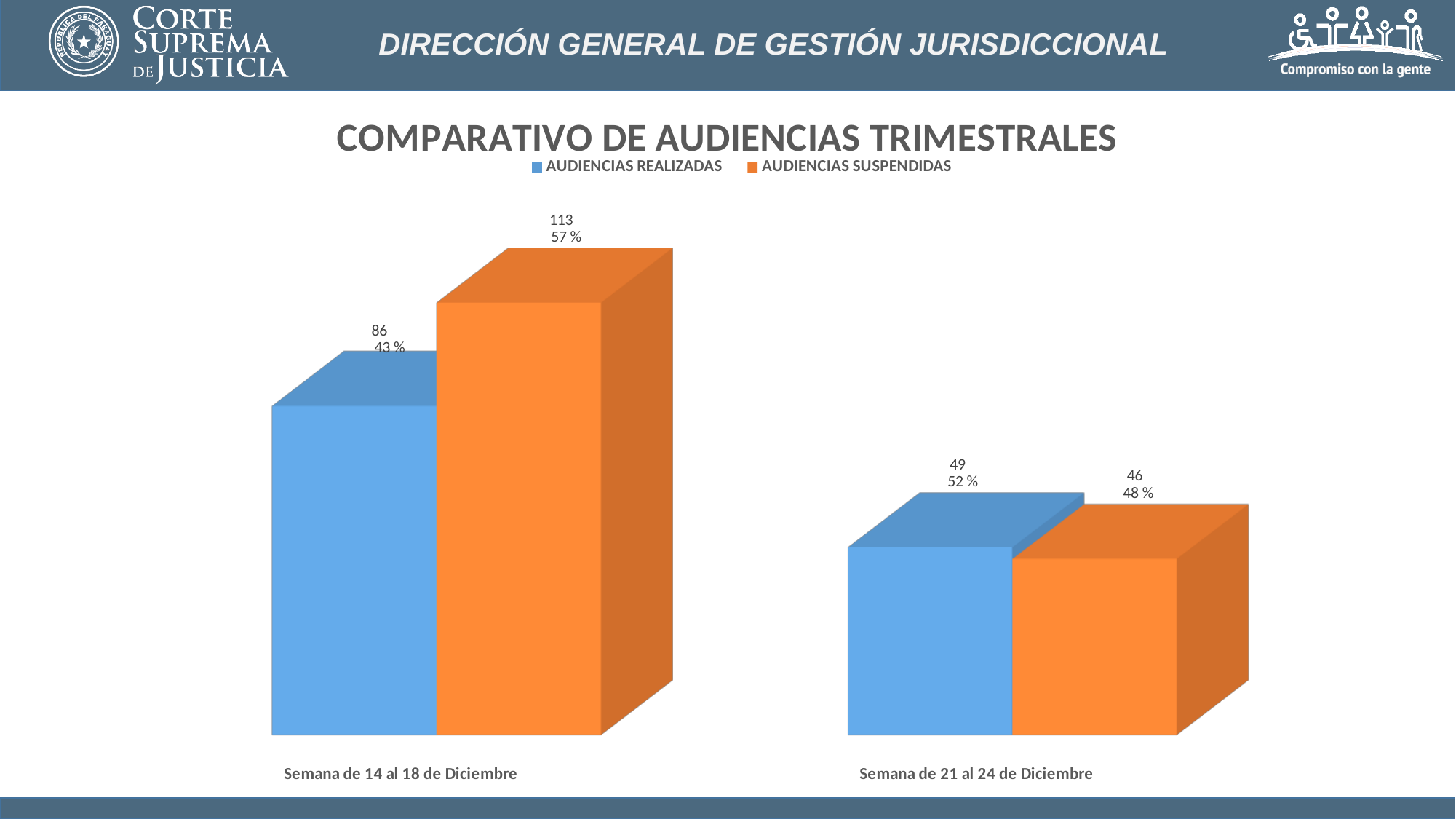
What is the difference between AUDIENCIAS SUSPENDIDAS and AUDIENCIAS REALIZADAS for Semana de 14 al 18 de Diciembre? 27 Which series has the highest value in Semana de 14 al 18 de Diciembre? AUDIENCIAS SUSPENDIDAS What is the value of AUDIENCIAS REALIZADAS for Semana de 14 al 18 de Diciembre? 86 What type of chart is shown on the slide? Bar chart What is the value of AUDIENCIAS REALIZADAS for Semana de 21 al 24 de Diciembre? 49 Which is larger for Semana de 21 al 24 de Diciembre: AUDIENCIAS REALIZADAS or AUDIENCIAS SUSPENDIDAS? AUDIENCIAS REALIZADAS What is the value of AUDIENCIAS SUSPENDIDAS for Semana de 21 al 24 de Diciembre? 46 How many series does the legend list? 2 What percentage is shown for AUDIENCIAS SUSPENDIDAS in Semana de 14 al 18 de Diciembre? 57 % What is the value of AUDIENCIAS SUSPENDIDAS for Semana de 14 al 18 de Diciembre? 113 How many categories are shown on the x axis? 2 What percentage is shown for AUDIENCIAS REALIZADAS in Semana de 21 al 24 de Diciembre? 52 %